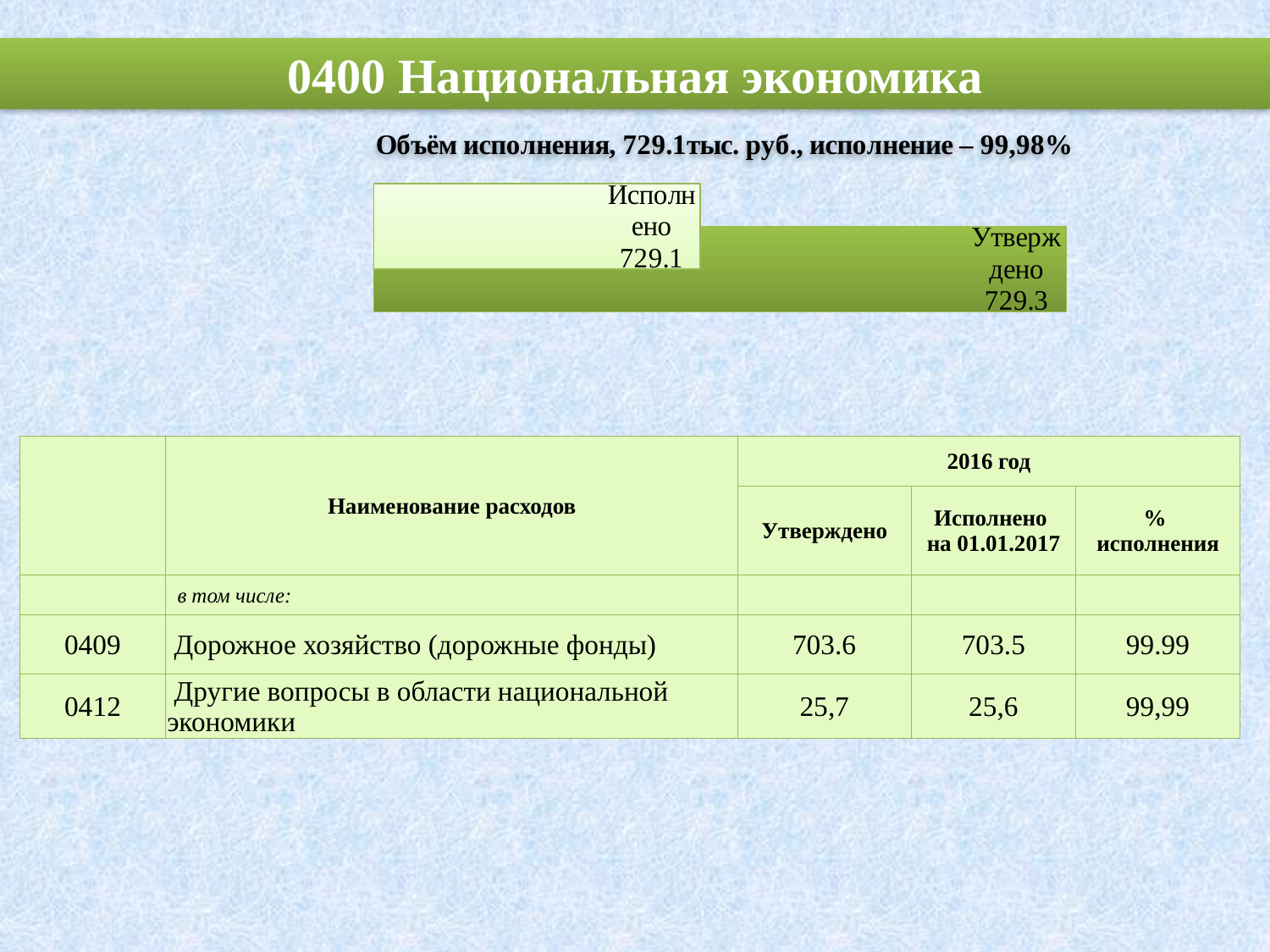
What is the title of the slide containing the chart? 0400 Национальная экономика Which bar in the chart has the lowest value? Исполнено What kind of chart is shown on the slide? bar chart What is the value of the bar labelled Утверждено? 729.3 Which bar in the chart has the highest value? Утверждено Which bar has the higher value, Исполнено or Утверждено? Утверждено What is the difference between the Утверждено value and the Исполнено value? 0.2 Are the bars in the chart drawn horizontally or vertically? horizontally What is the value of the bar labelled Исполнено? 729.1 How many bars are plotted in the chart? 2